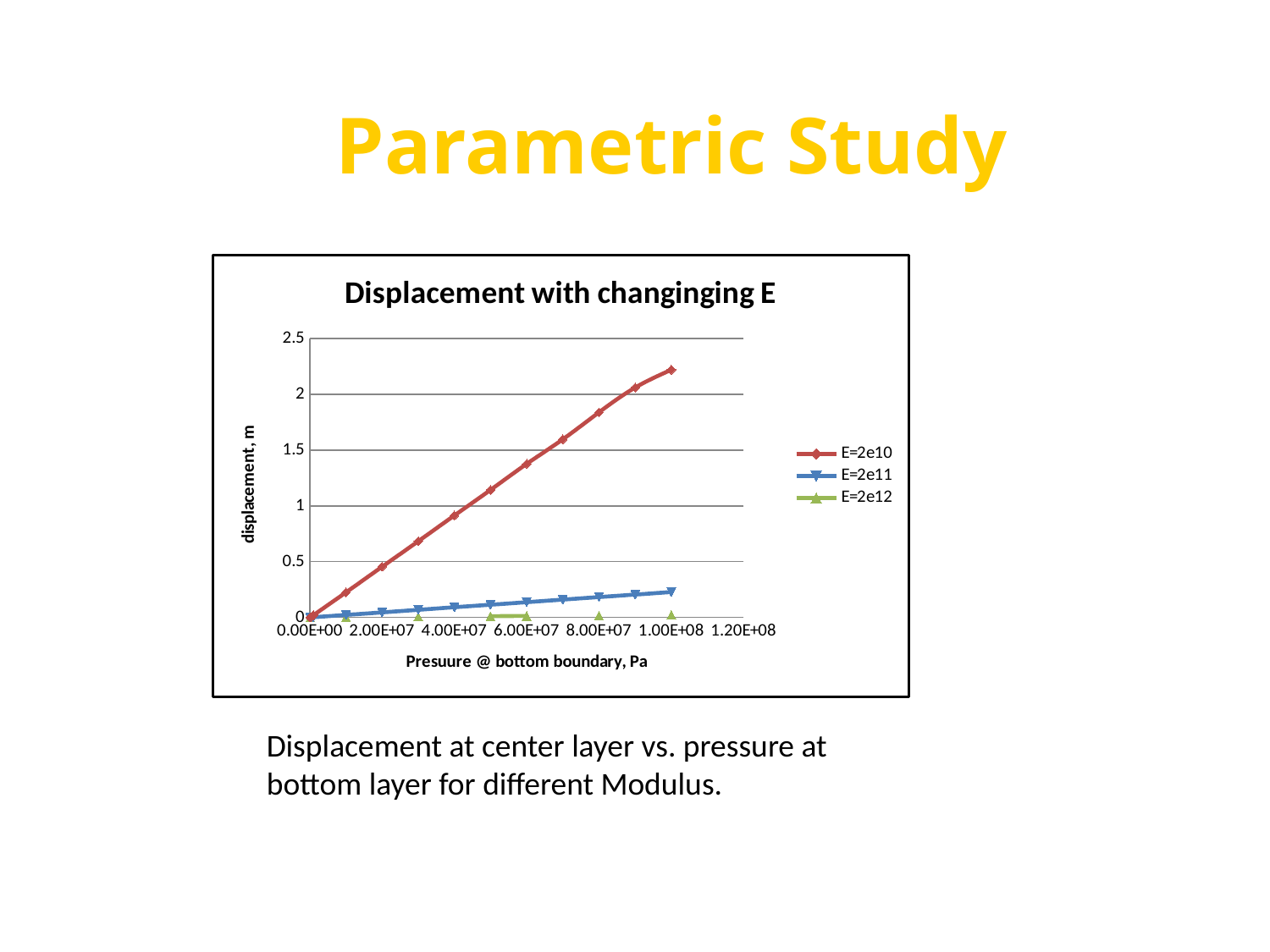
Which series has the lowest displacement across the pressure range? E=2e12 What is the label of the y axis? displacement, m Which series has the larger displacement at a pressure of 8.00E+07, E=2e10 or E=2e11? E=2e10 Is the displacement for E=2e10 at a pressure of 1.00E+08 greater or less than 2? greater What is the title of the chart? Displacement with changinging E What is the displacement for E=2e10 at a pressure of 0.00E+00? 0 Does the displacement for E=2e10 rise or fall as pressure increases? rise How many series does the legend list? 3 Which series reaches the highest displacement? E=2e10 Is the displacement for E=2e10 at a pressure of 4.00E+07 greater or less than 1? less What kind of chart is shown on the slide? line chart Is the displacement for E=2e11 at a pressure of 1.00E+08 greater or less than 0.5? less